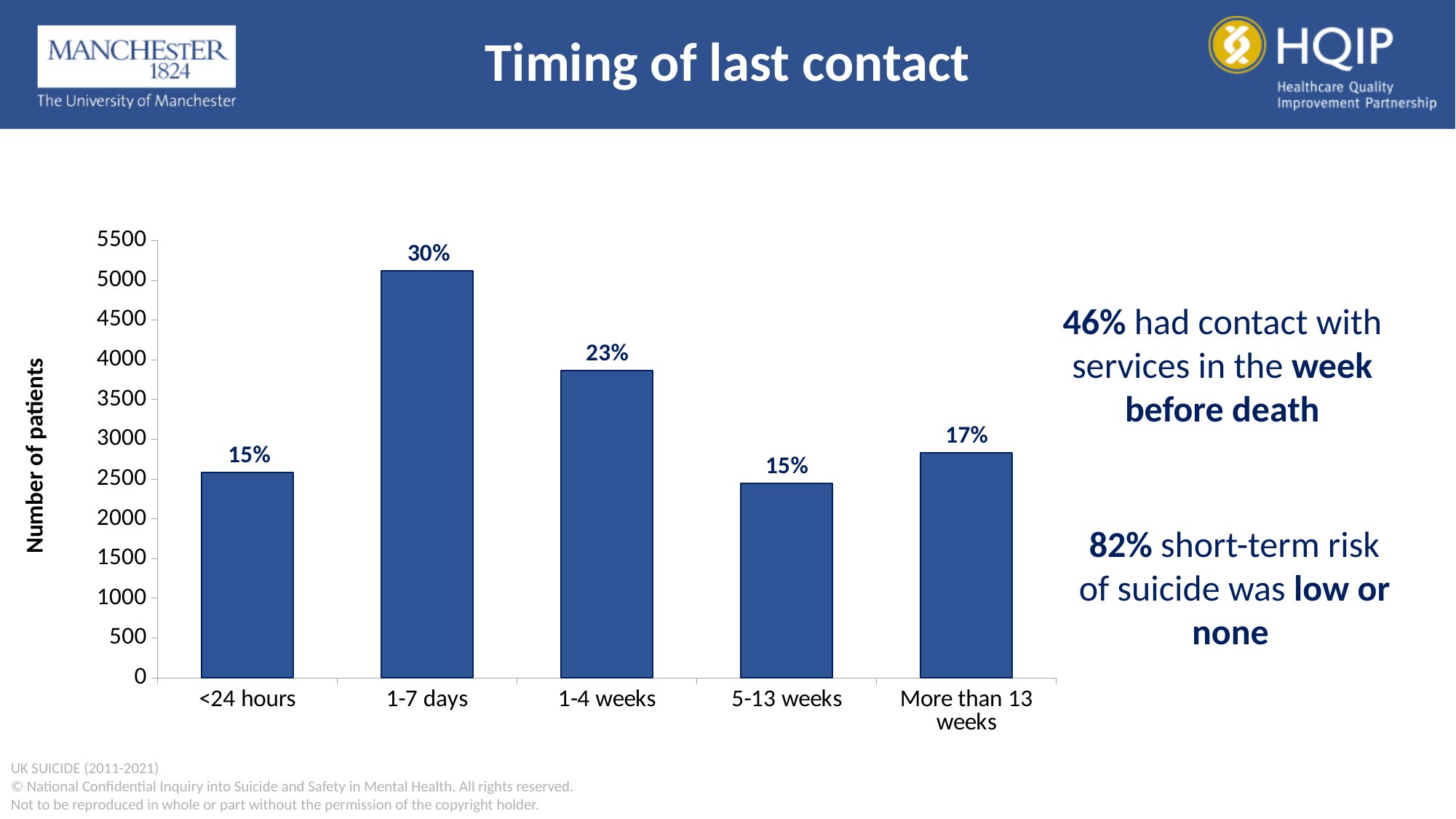
What percentage label is shown on the bar for 1-4 weeks? 23% Which has more patients, 1-4 weeks or More than 13 weeks? 1-4 weeks What percentage label is shown on the bar for 1-7 days? 30% How many categories are shown on the x axis of the chart? 5 What is the difference between the percentage labels for 1-7 days and 5-13 weeks? 15% Is the number of patients for 1-7 days greater or less than 5000? greater What percentage label is shown on the bar for More than 13 weeks? 17% What percentage label is shown on the bar for <24 hours? 15% Is the number of patients for 1-4 weeks greater or less than 4000? less What kind of chart is shown on the slide? bar chart Which category has the highest number of patients? 1-7 days